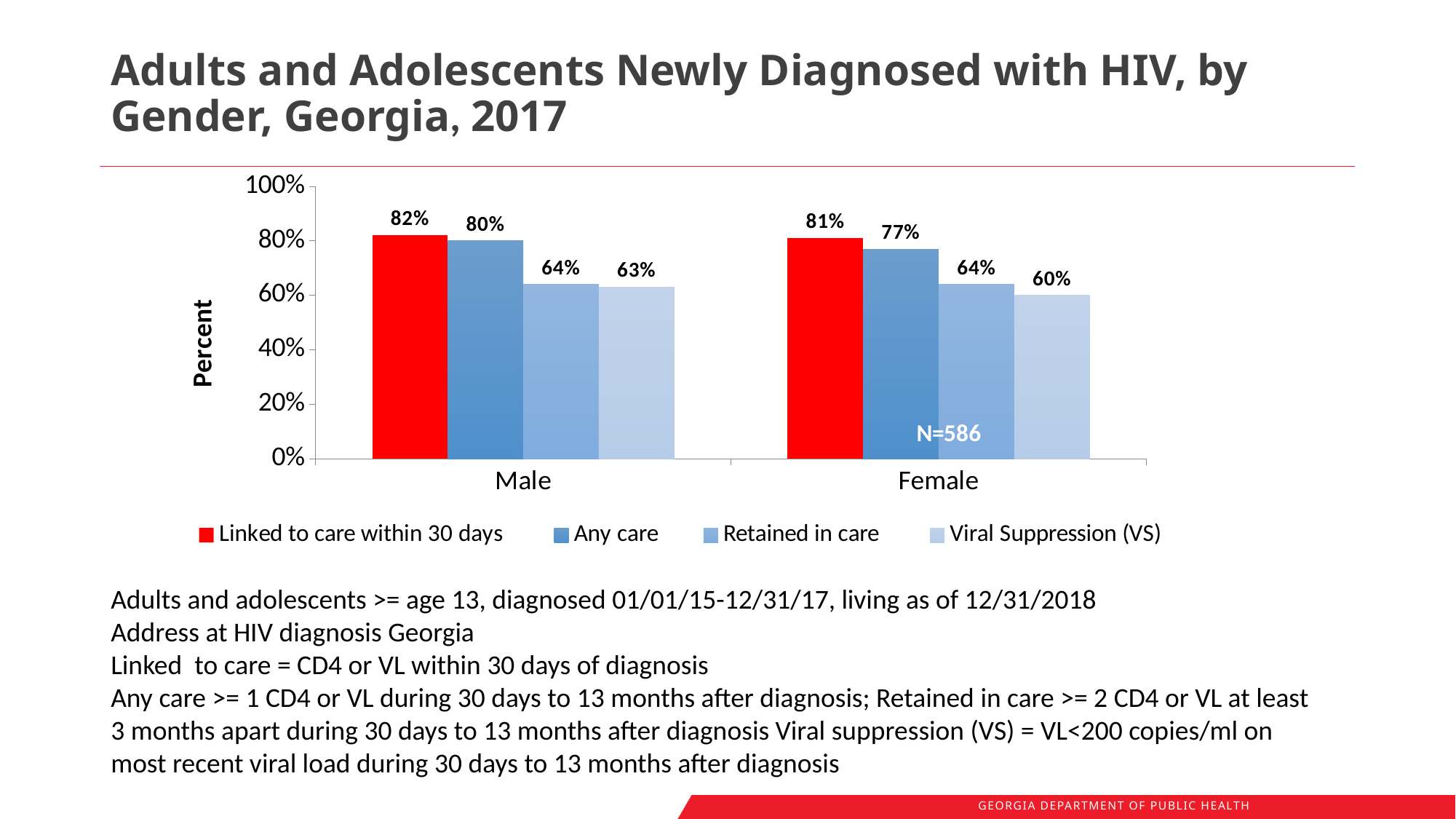
How many gender categories are shown on the x axis? 2 What is the Retained in care value for males? 64% Is the Viral Suppression (VS) value higher for males or females? Males What is the N value printed on the chart? N=586 What is the Any care value for females? 77% Which series has the highest value for males? Linked to care within 30 days What kind of chart is shown on the slide? Bar chart What is the difference between the Any care values for males and females? 3% How many series does the legend list? 4 Which series has the lowest value for females? Viral Suppression (VS) What is the Viral Suppression (VS) value for females? 60% What percentage of males were linked to care within 30 days? 82%